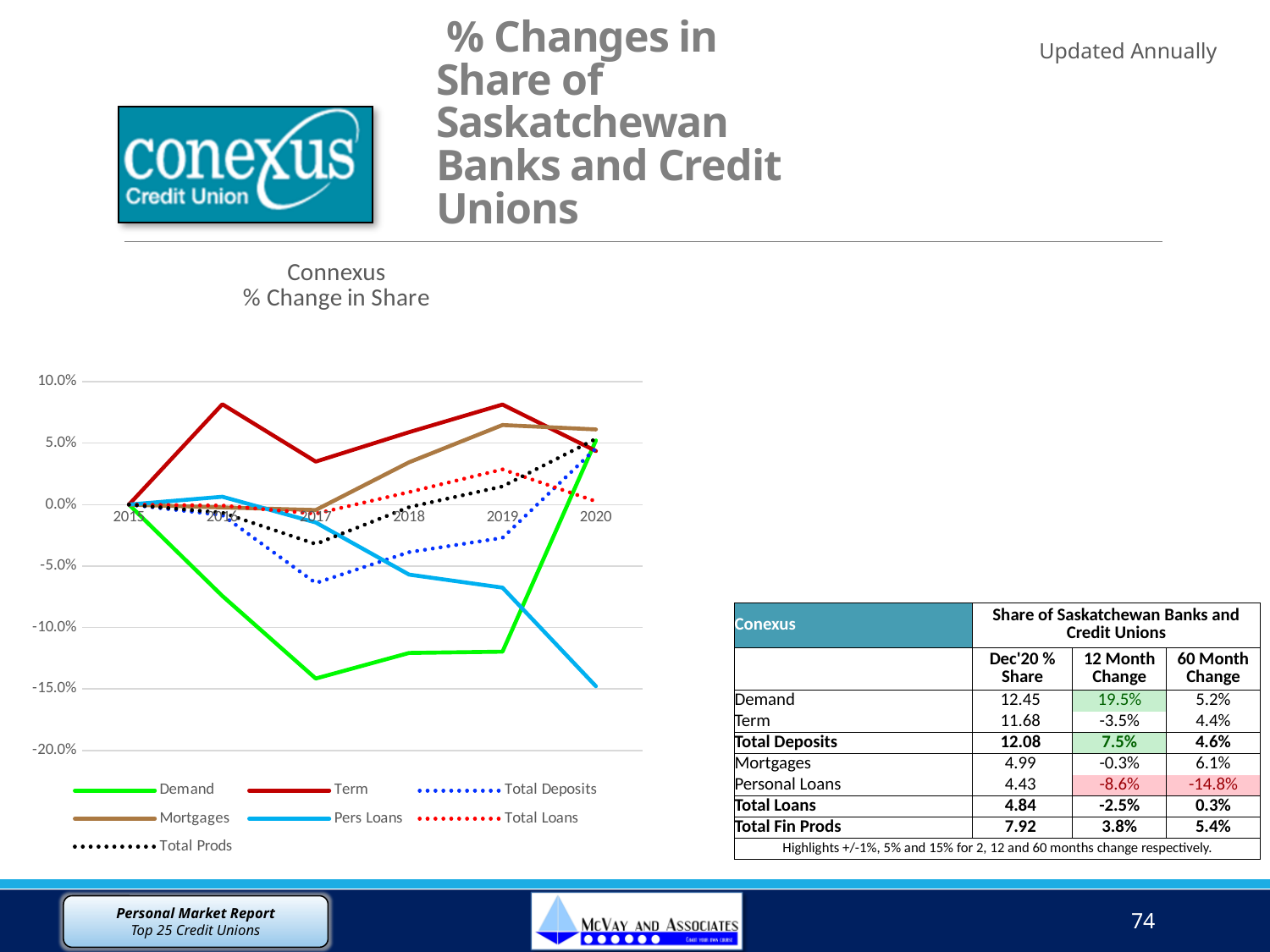
In 2018, which is larger, the value for Demand or the value for Term? Term How many series does the chart legend list? 7 Does the Pers Loans line rise or fall from 2017 to 2020? fall Is the value for Term in 2016 greater or less than 5.0%? greater Which series has the lowest value in 2017? Demand Is the value for Pers Loans in 2020 greater or less than -10.0%? less Which series has the highest value in 2019? Term Which series is drawn with the solid green line? Demand What kind of chart is shown on the slide? line chart How many years are shown along the x axis of the chart? 6 Is the value for Demand in 2017 greater or less than -10.0%? less Which series has the lowest value in 2020? Pers Loans